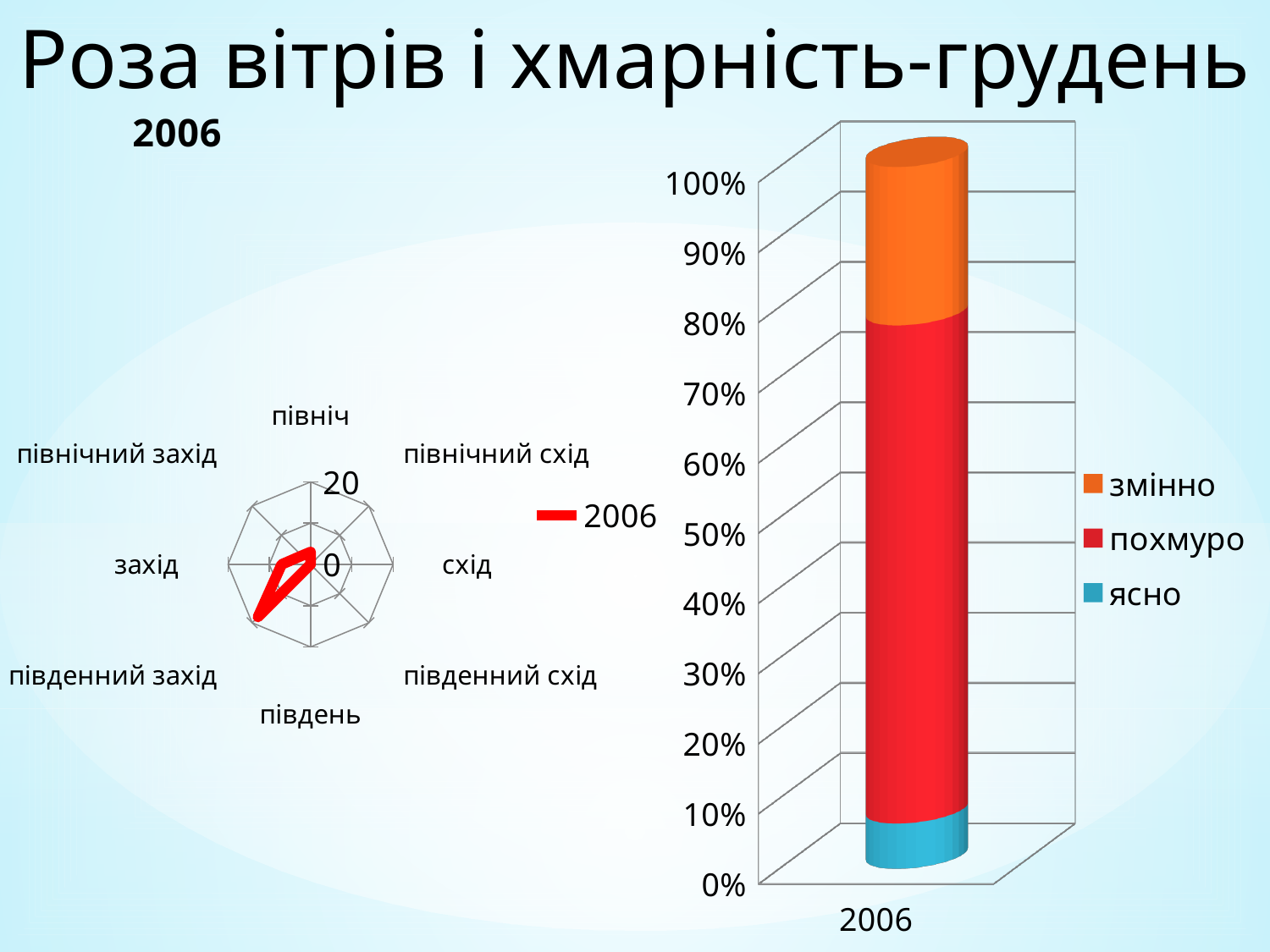
How many series does the legend of the right-hand bar chart list? 3 In the right-hand bar chart, is the share for ясно greater or less than 10%? less In the left-hand radar chart, is the value for південний захід greater or less than 10? greater In the right-hand bar chart, which series takes up the smallest part of the stacked bar? ясно How many categories are shown on the x axis of the right-hand bar chart? 1 How many direction categories does the left-hand radar chart have? 8 What kind of chart is the chart on the left side of the slide? radar chart In the right-hand bar chart, which segment is larger: змінно or ясно? змінно In the right-hand bar chart, which series takes up the largest part of the stacked bar? похмуро In the left-hand radar chart, which direction has the highest value? південний захід What is the category label on the x axis of the right-hand bar chart? 2006 What kind of chart is the chart on the right side of the slide? bar chart